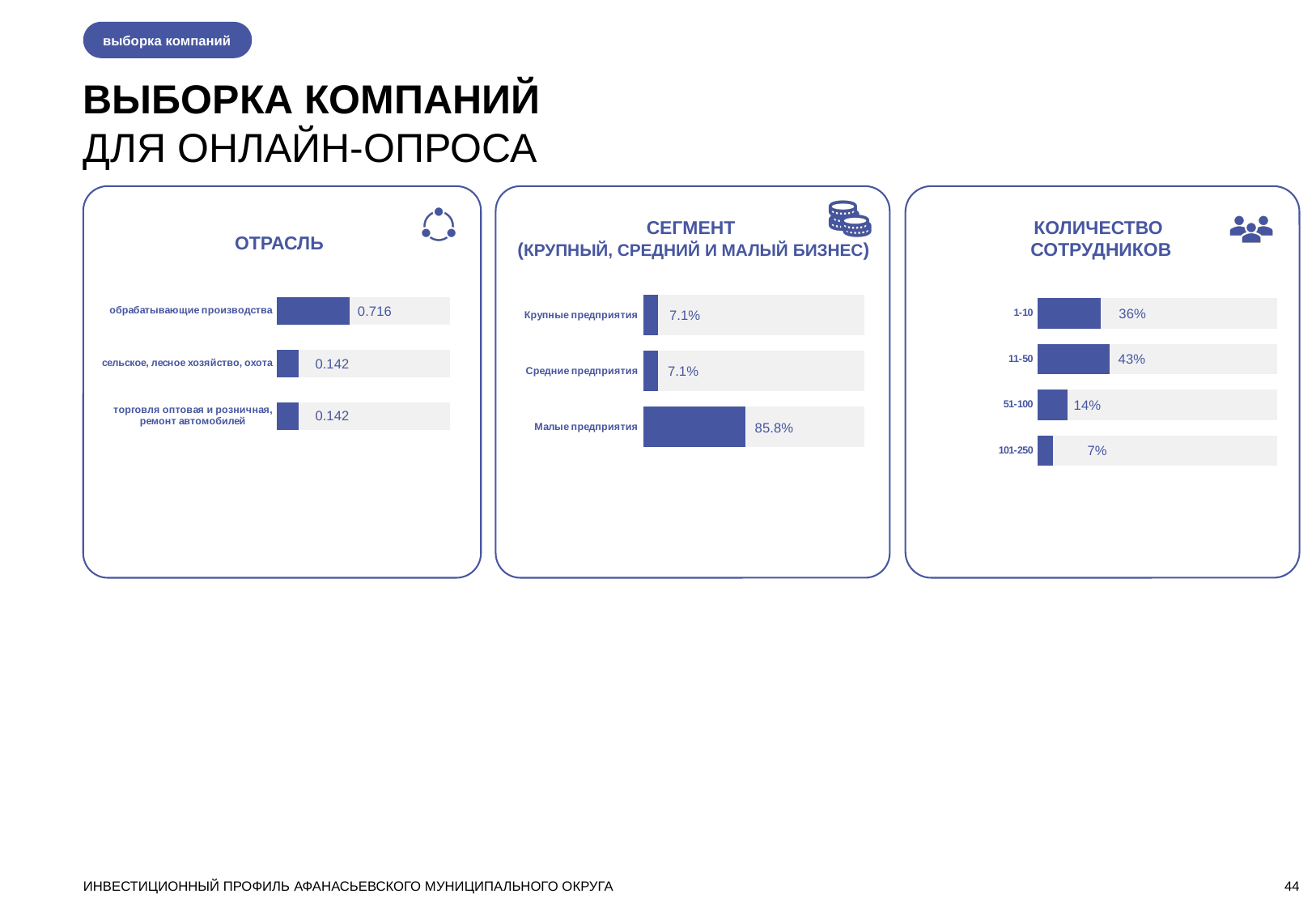
In the 'КОЛИЧЕСТВО СОТРУДНИКОВ' chart, which category has the lowest value? 101-250 In the 'СЕГМЕНТ' chart, what is the value for 'Малые предприятия'? 85.8% What type of chart is the 'КОЛИЧЕСТВО СОТРУДНИКОВ' chart? Bar chart In the 'ОТРАСЛЬ' chart, what is the value for 'обрабатывающие производства'? 0.716 In the 'ОТРАСЛЬ' chart, which category has the highest value? обрабатывающие производства In the 'ОТРАСЛЬ' chart, how many categories are shown? 3 In the 'ОТРАСЛЬ' chart, what is the difference between 'обрабатывающие производства' and 'сельское, лесное хозяйство, охота'? 0.574 In the 'СЕГМЕНТ' chart, which category has the highest value? Малые предприятия In the 'КОЛИЧЕСТВО СОТРУДНИКОВ' chart, what is the value for '11-50'? 43% In the 'КОЛИЧЕСТВО СОТРУДНИКОВ' chart, what is the difference between '11-50' and '1-10'? 7% In the 'СЕГМЕНТ' chart, what is the value for 'Крупные предприятия'? 7.1% In the 'КОЛИЧЕСТВО СОТРУДНИКОВ' chart, which is larger: '1-10' or '51-100'? 1-10